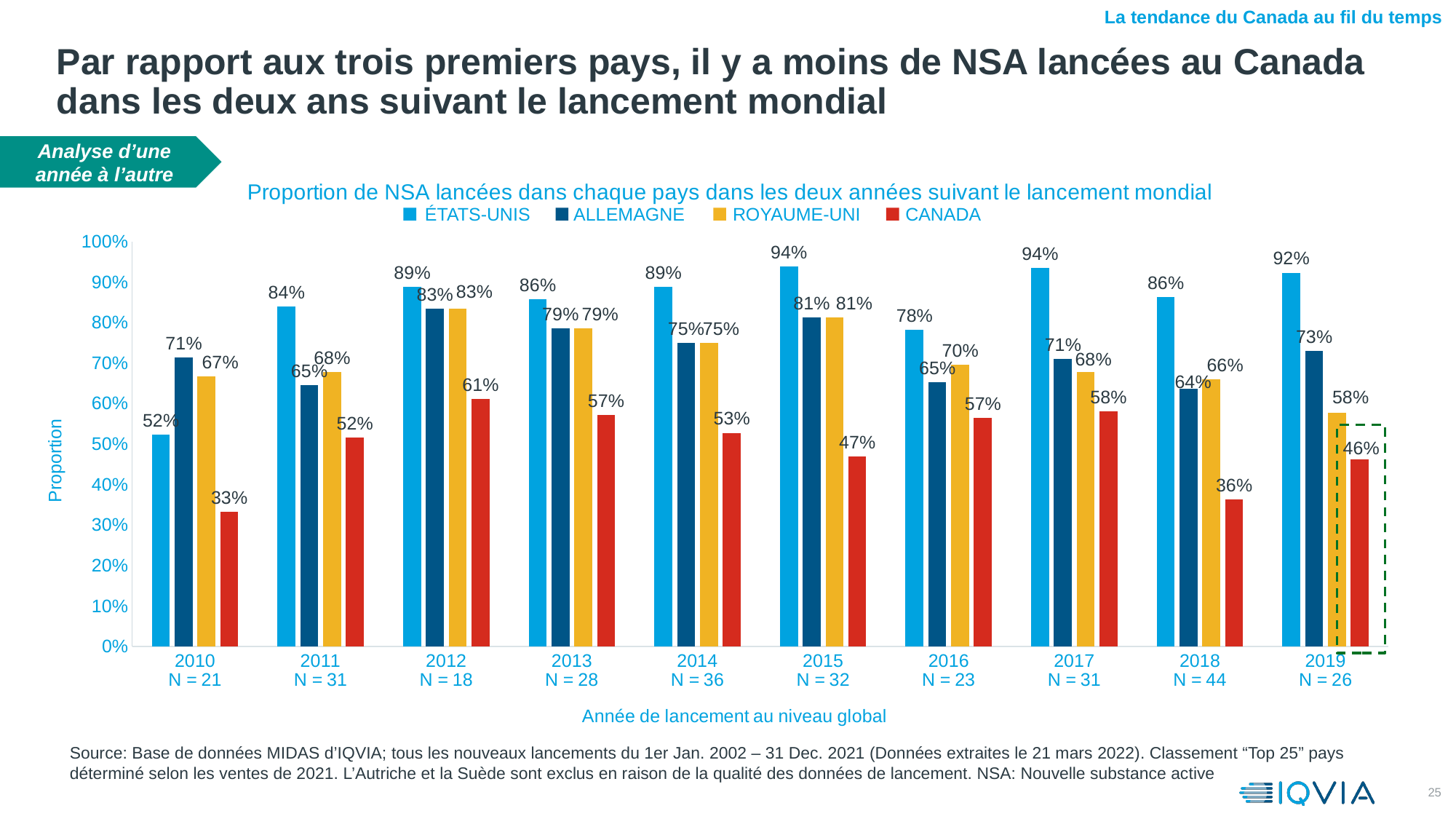
What kind of chart is this? Bar chart What is the value for CANADA in 2010? 33% In which year is the ALLEMAGNE value highest? 2012 What is the value for ALLEMAGNE in 2018? 64% In which year is the CANADA value lowest? 2010 What is the difference between the ÉTATS-UNIS and CANADA values in 2015? 47% What is the value for ÉTATS-UNIS in 2019? 92% Which is larger in 2010: the ÉTATS-UNIS value or the ALLEMAGNE value? ALLEMAGNE How many series does the legend list? 4 What is the N value shown for 2018? N = 44 How many years are shown on the x axis? 10 What is the value for ROYAUME-UNI in 2016? 70%